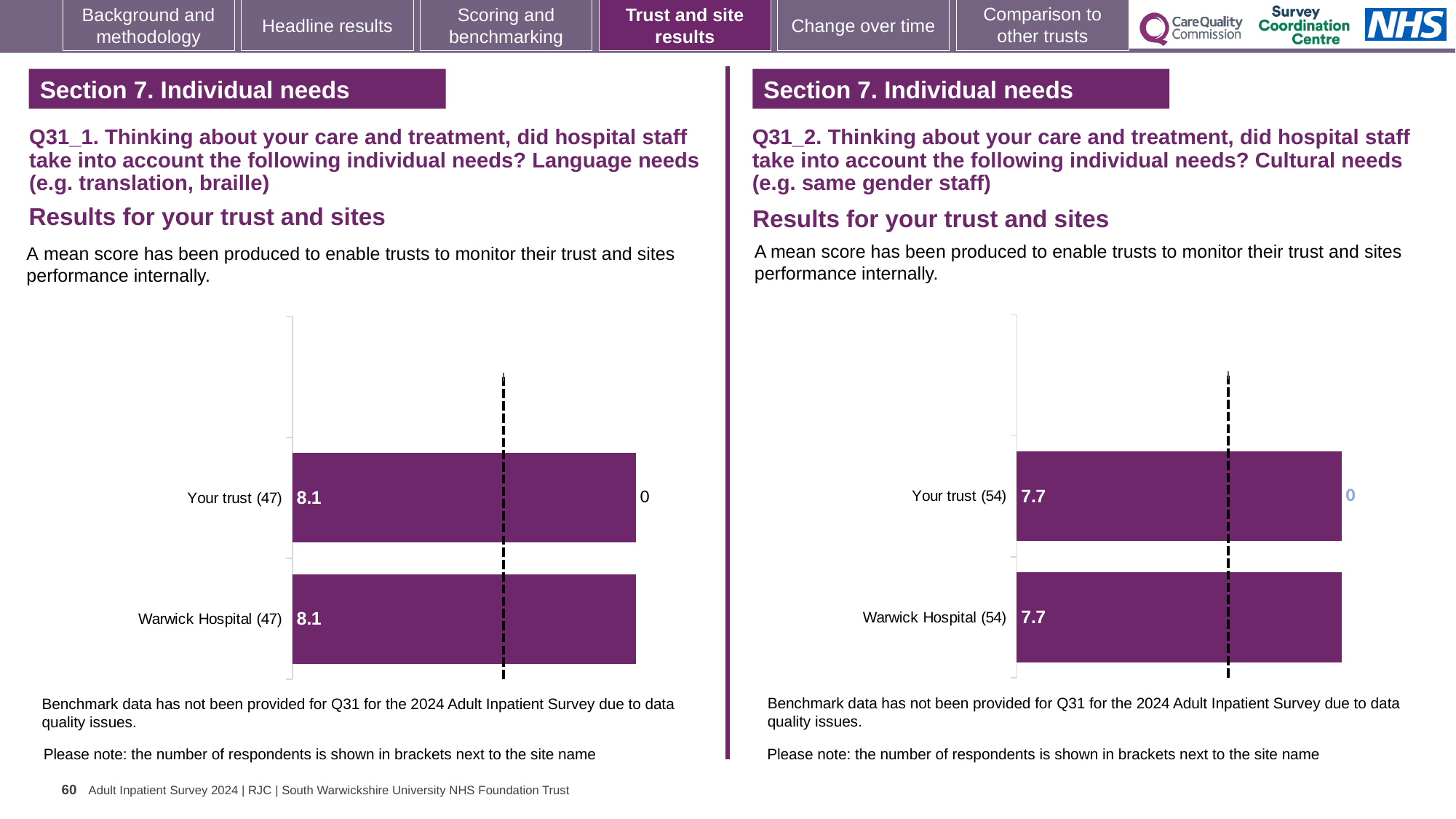
On the right chart (Q31_2, Cultural needs), what is the mean score for Your trust (54)? 7.7 On the left chart (Q31_1, Language needs), how many respondents are shown in brackets for Warwick Hospital? 47 On the right chart (Q31_2, Cultural needs), how many respondents are shown in brackets for Your trust? 54 On the right chart (Q31_2, Cultural needs), what is the mean score for Warwick Hospital (54)? 7.7 On the left chart (Q31_1, Language needs), what is the mean score for Warwick Hospital (47)? 8.1 How many bars are plotted on the right chart (Q31_2, Cultural needs)? 2 What type of chart is used on the right (Q31_2, Cultural needs)? Bar chart What type of chart is used on the left (Q31_1, Language needs)? Bar chart On the left chart (Q31_1, Language needs), what is the difference between the scores for Your trust and Warwick Hospital? 0.0 On the left chart (Q31_1, Language needs), what is the mean score for Your trust (47)? 8.1 How many bars are plotted on the left chart (Q31_1, Language needs)? 2 On the right chart (Q31_2, Cultural needs), what is the difference between the scores for Your trust and Warwick Hospital? 0.0